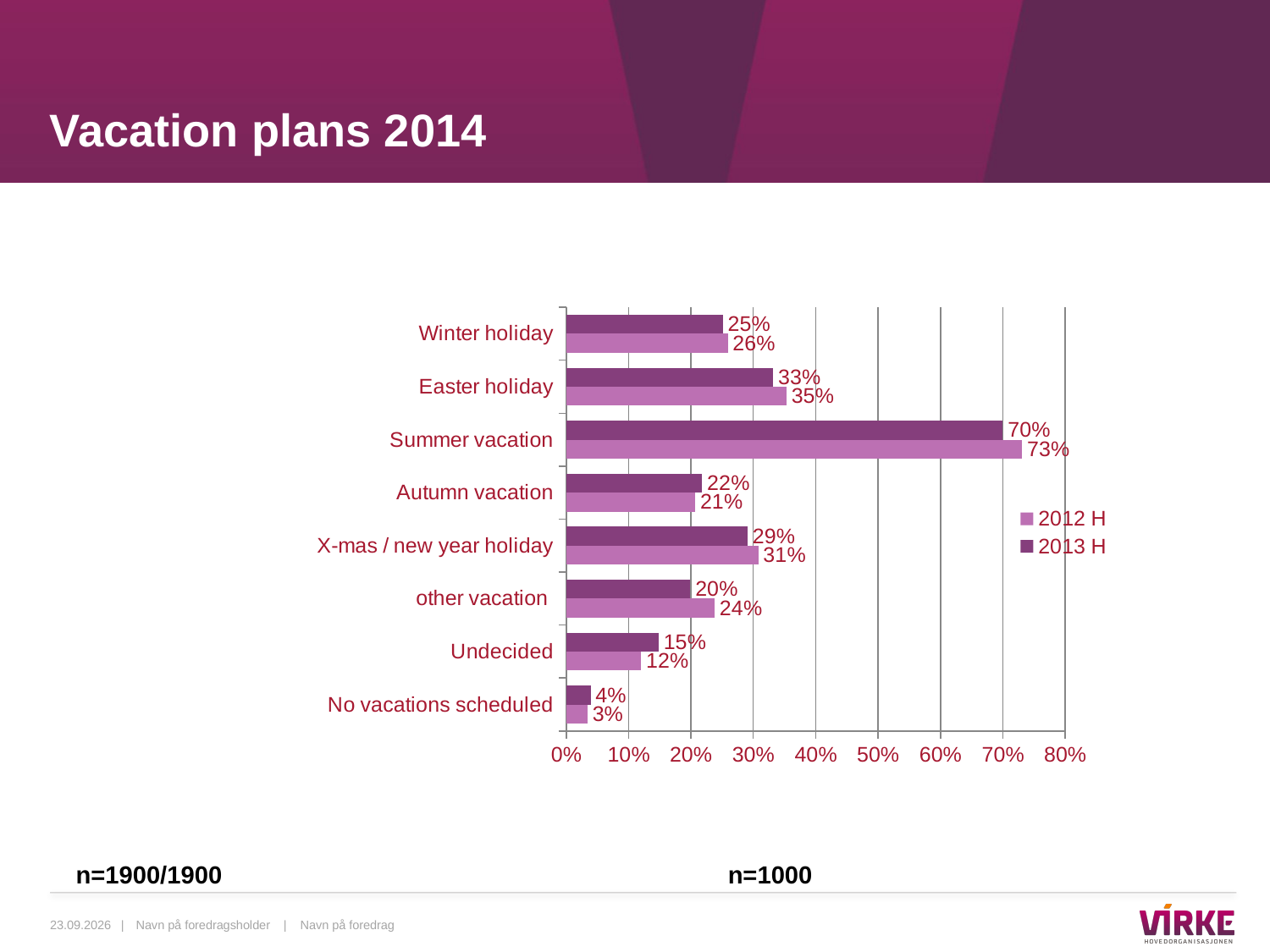
Which is larger for X-mas / new year holiday, the 2012 H value or the 2013 H value? 2012 H What is the difference between the 2012 H and 2013 H values for other vacation? 4% Which category has the highest 2012 H value? Summer vacation Which category has the lowest 2013 H value? No vacations scheduled How many series does the legend list? 2 What kind of chart is shown on the slide? bar chart What is the 2013 H value for Undecided? 15% Is the 2012 H value for Summer vacation greater or less than 60%? greater What is the 2013 H value for Summer vacation? 70% What is the 2012 H value for Easter holiday? 35% How many categories are shown on the chart? 8 What is the title of the slide containing the chart? Vacation plans 2014